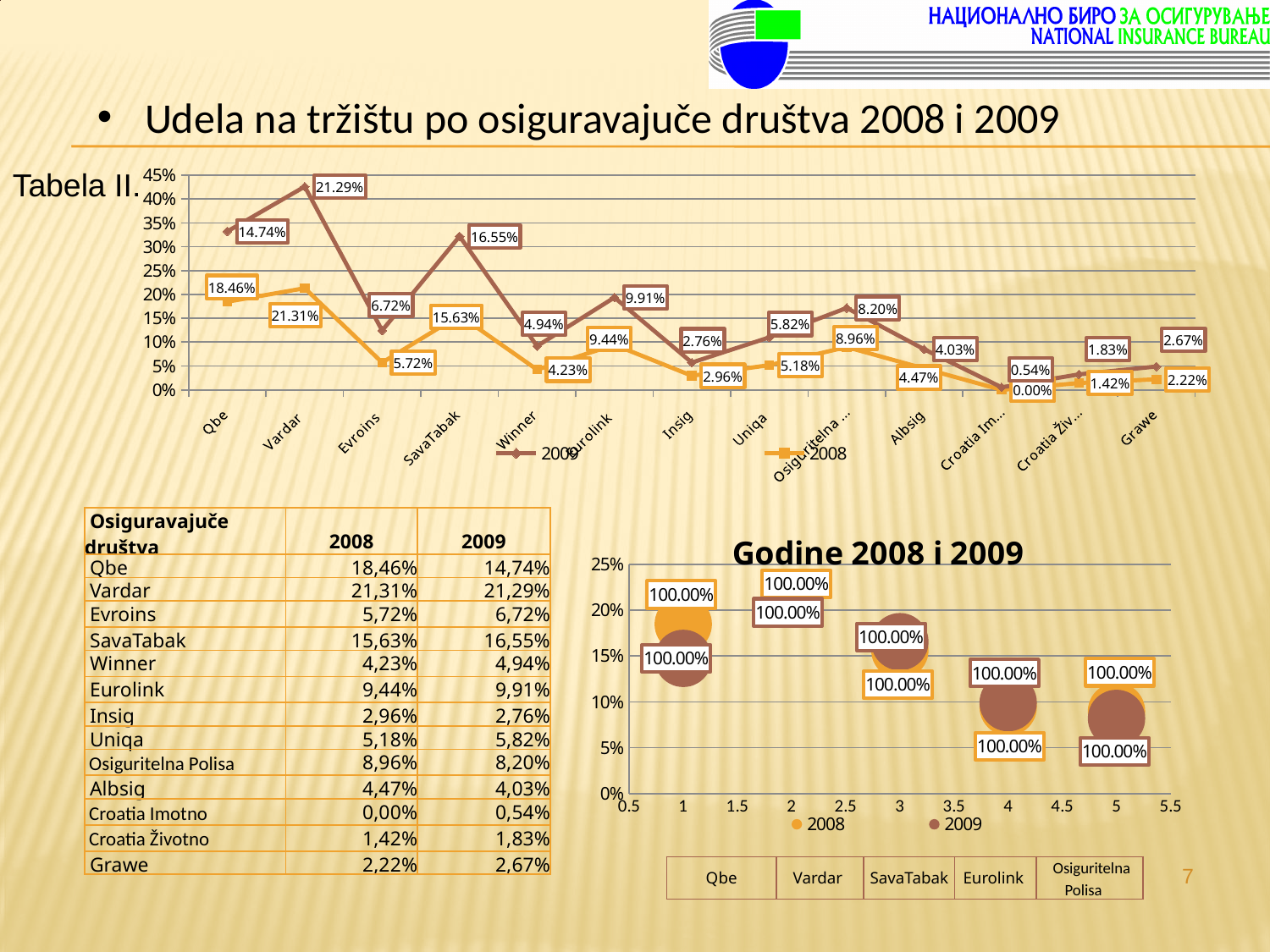
In the top line chart, which is larger for Eurolink, the 2008 value or the 2009 value? 2009 What type of chart is the chart titled 'Godine 2008 i 2009'? bubble chart What is the title of the chart at the bottom right of the slide? Godine 2008 i 2009 How many companies are shown on the x axis of the top line chart? 13 In the top line chart, what is the 2009 value for Croatia Im...? 0.54% In the top line chart, what is the 2008 value for Qbe? 18.46% How many series does the legend of the top line chart list? 2 In the top line chart, which company has the highest 2008 value? Vardar In the top line chart, what is the difference between the 2009 and 2008 values for Evroins? 1.00% In the top line chart, what is the 2009 value for SavaTabak? 16.55% In the top line chart, which company has the lowest 2008 value? Croatia Im... What type of chart is the chart at the top of the slide? line chart